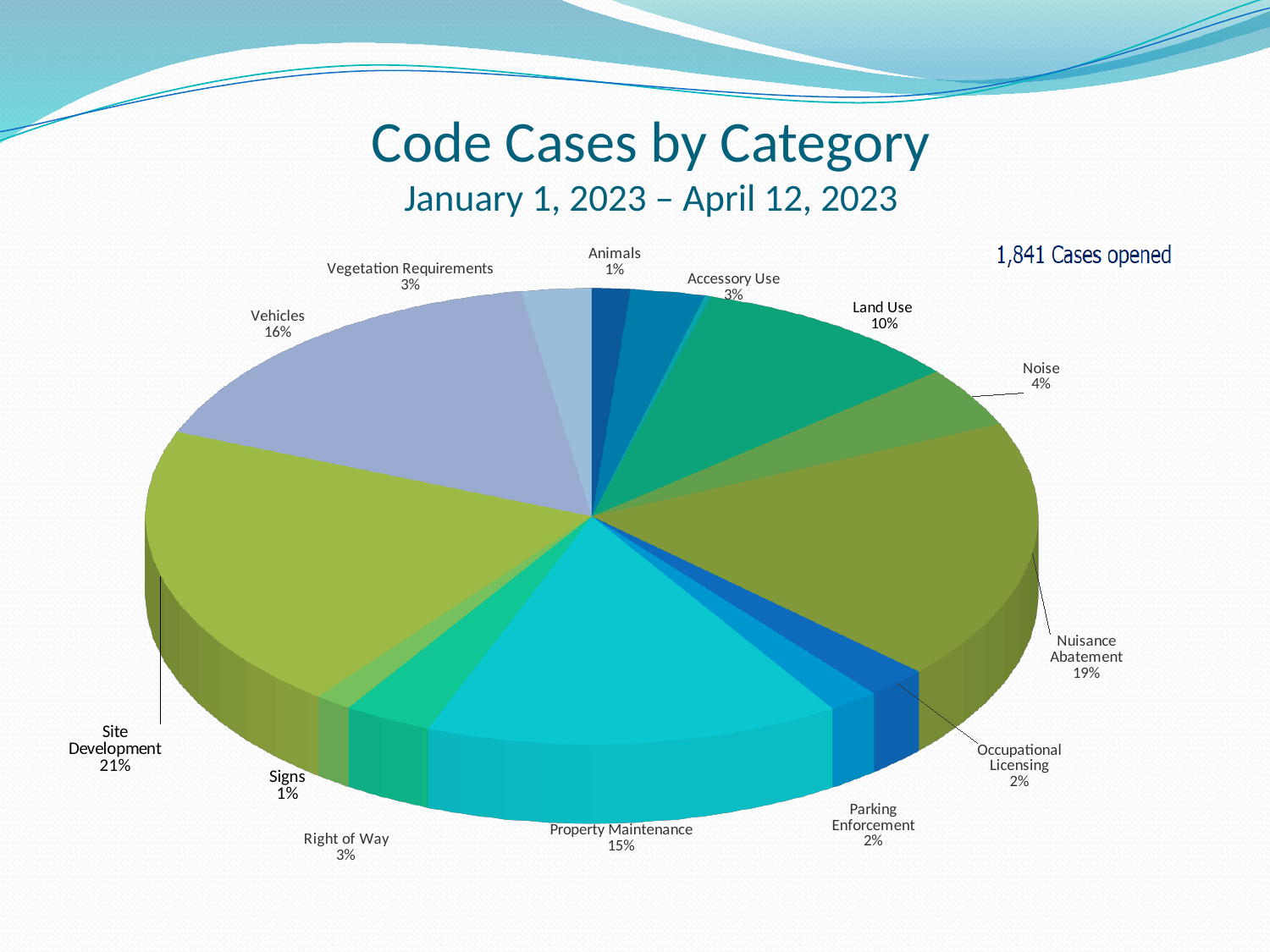
How many cases were opened in total according to the slide? 1,841 What share of code cases is Land Use? 10% What share of code cases is Noise? 4% Which has a larger share, Vehicles or Property Maintenance? Vehicles What is the difference in percentage points between Site Development and Nuisance Abatement? 2 How many categories are shown in the pie chart? 13 What date range does the chart cover? January 1, 2023 – April 12, 2023 What share of code cases is Property Maintenance? 15% Which category has the largest share of code cases? Site Development What kind of chart is shown on the slide? pie chart What share of code cases is Nuisance Abatement? 19% What share of code cases is Site Development? 21%